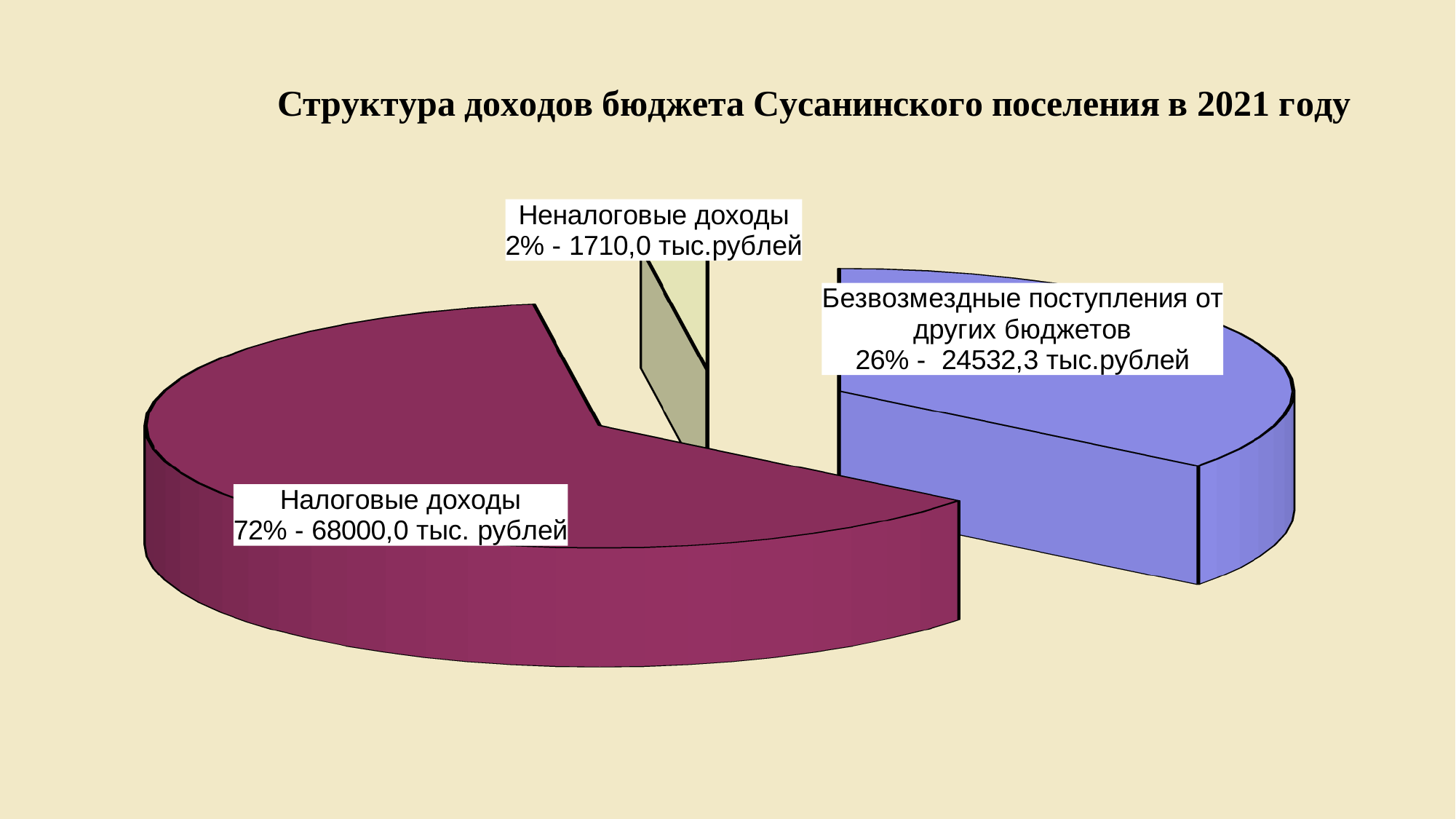
What is the title of the chart? Структура доходов бюджета Сусанинского поселения в 2021 году What share of the pie does Неналоговые доходы represent? 2% What type of chart is shown on the slide? Pie chart What share of the pie does Налоговые доходы represent? 72% Which category has the largest share of the pie? Налоговые доходы What is the value shown for Налоговые доходы? 68000,0 тыс. рублей How many slices does the pie chart have? 3 Which category has the smallest share of the pie? Неналоговые доходы Which is larger: the share for Безвозмездные поступления от других бюджетов or the share for Неналоговые доходы? Безвозмездные поступления от других бюджетов What is the value shown for Безвозмездные поступления от других бюджетов? 24532,3 тыс.рублей What is the value shown for Неналоговые доходы? 1710,0 тыс.рублей What share of the pie does Безвозмездные поступления от других бюджетов represent? 26%